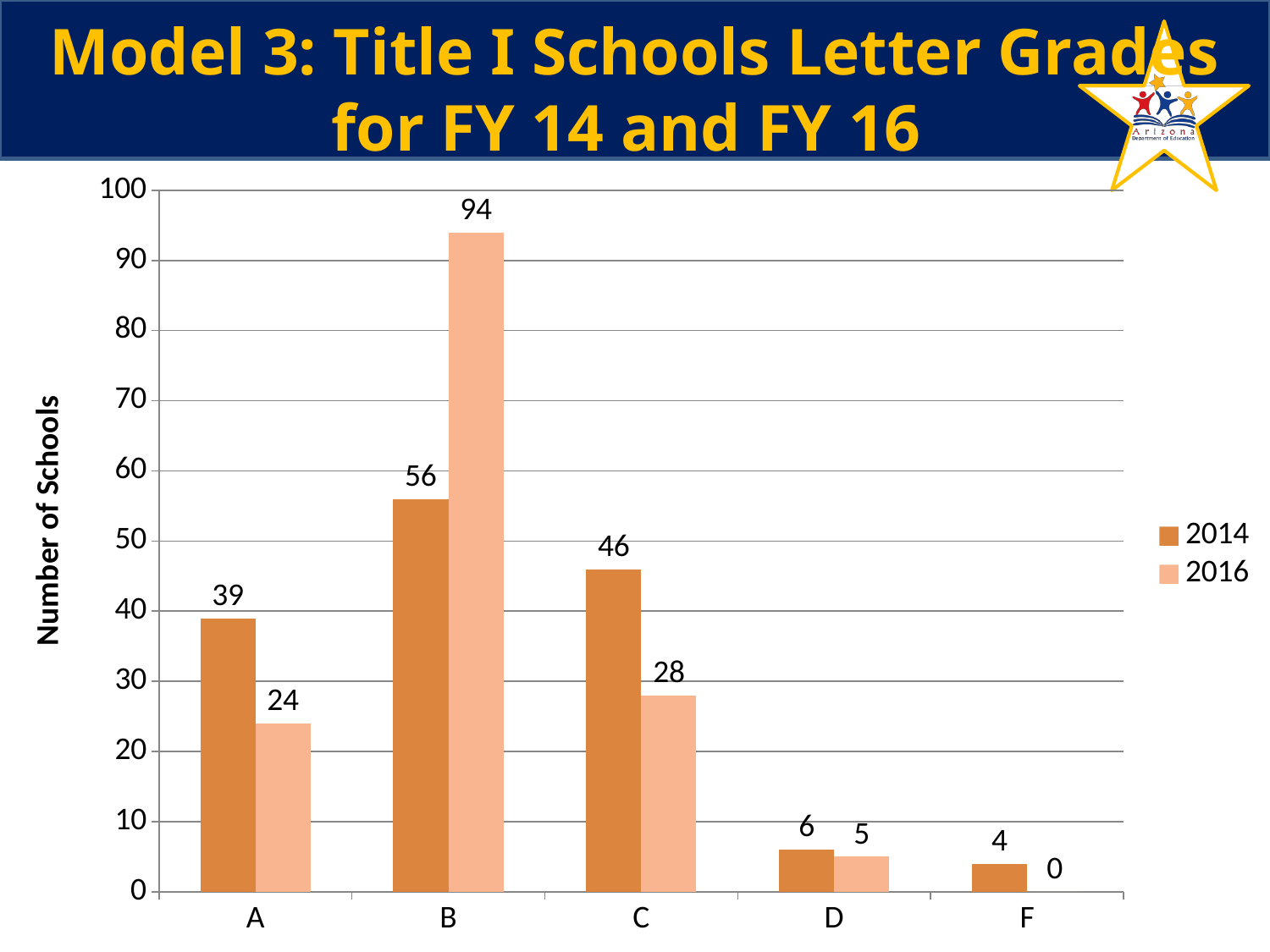
What is the difference between the 2014 and 2016 values for grade C? 18 What type of chart is shown on the slide? Bar chart What is the difference between the 2016 and 2014 values for grade B? 38 What is the value for grade A in the 2014 series? 39 Is the 2016 value for grade B greater or less than 90? greater How many schools received an F in 2016? 0 Which letter grade has the lowest number of schools in 2016? F Which letter grade has the highest number of schools in 2014? B How many letter grade categories are shown on the x axis? 5 How many series does the legend list? 2 Which is larger for grade A: the 2014 value or the 2016 value? 2014 How many Title I schools received a B grade in 2016? 94